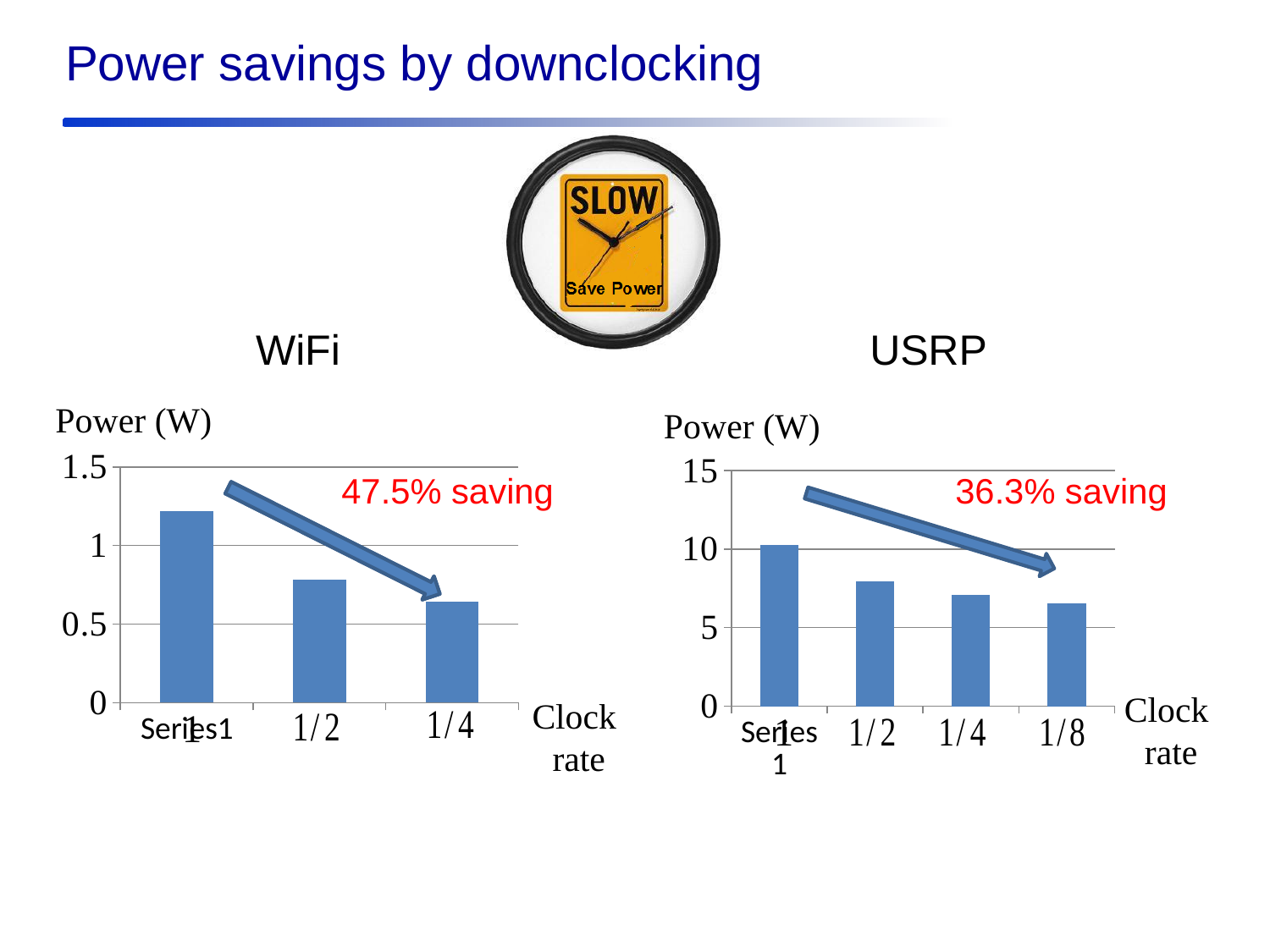
How many clock-rate categories does the USRP chart show? 4 What percentage saving is annotated on the USRP chart? 36.3% saving In the USRP chart, do the power values rise or fall as the clock rate goes from 1 to 1/8? fall In the WiFi chart, which clock rate has the lowest power? 1/4 In the USRP chart, which clock rate has the lowest power? 1/8 In the USRP chart, is the power at clock rate 1/2 greater or less than 10? less In the WiFi chart, is the power at clock rate 1/4 greater or less than 0.5? greater In the USRP chart, which clock rate has the highest power? 1 How many clock-rate categories does the WiFi chart show? 3 In the WiFi chart, is the power at clock rate 1 greater or less than 1? greater In the WiFi chart, which clock rate has the highest power? 1 What kind of chart is the WiFi chart? bar chart